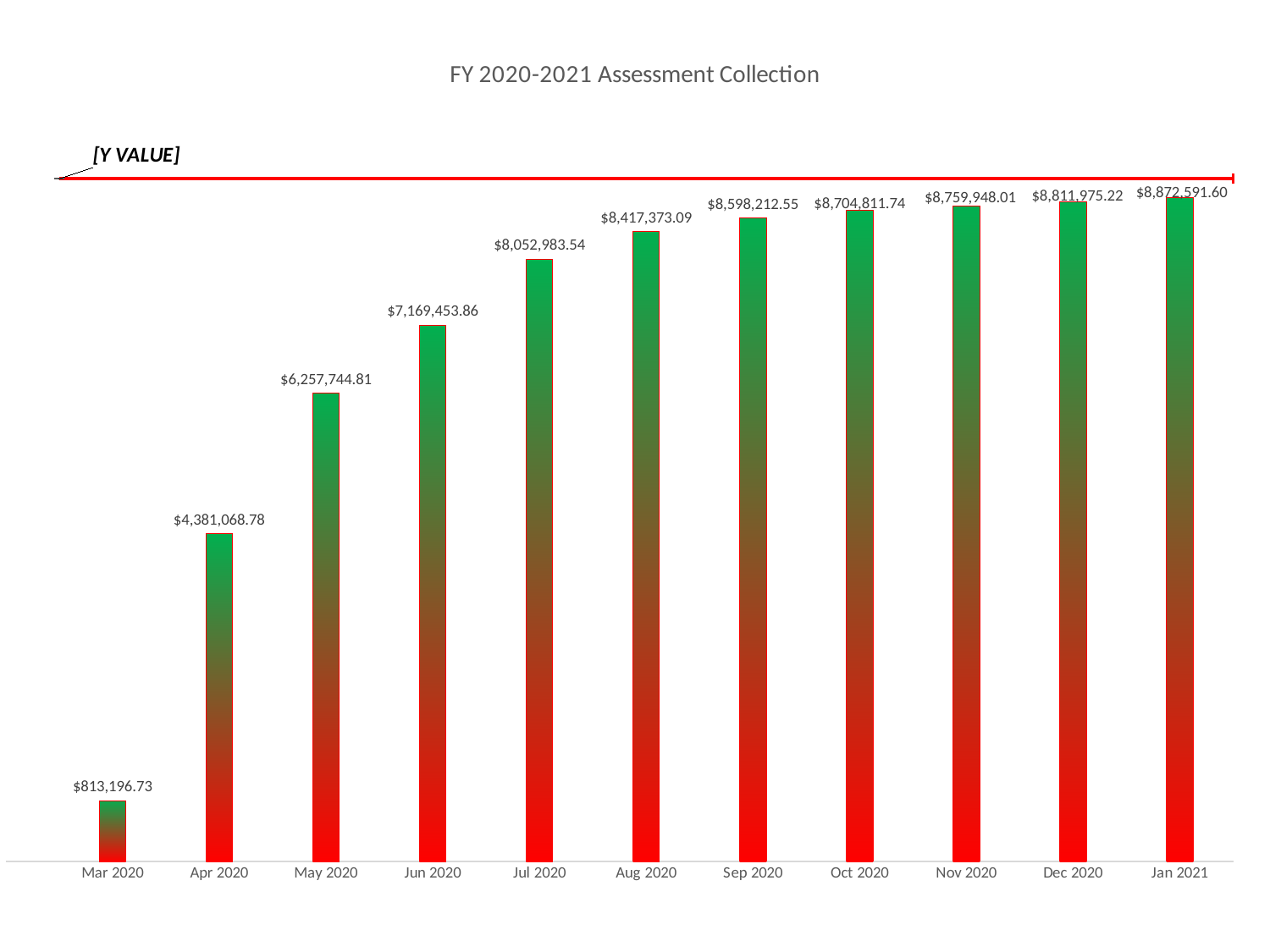
What is the value for Jan 2021? $8,872,591.60 What is the difference between the values for Apr 2020 and Mar 2020? $3,567,872.05 What is the difference between the values for Jun 2020 and May 2020? $911,709.05 Which month has the lowest value? Mar 2020 Which is larger, the value for May 2020 or the value for Aug 2020? Aug 2020 What kind of chart is this? Bar chart What is the value for Mar 2020? $813,196.73 Which month has the highest value? Jan 2021 What is the value for Oct 2020? $8,704,811.74 Do the values rise or fall from Mar 2020 to Jan 2021? Rise What is the value for Jul 2020? $8,052,983.54 How many months are shown on the x axis? 11